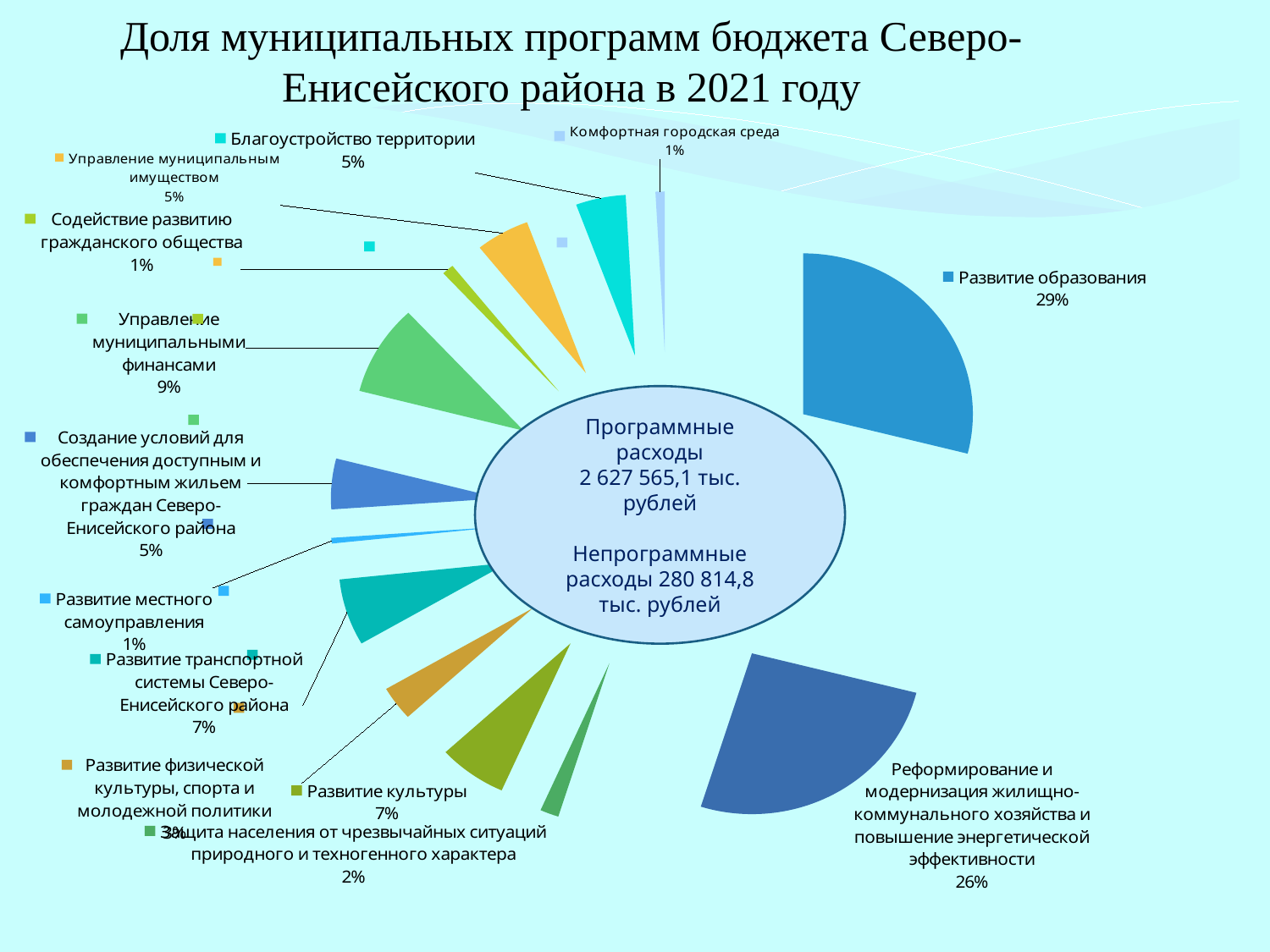
What is the combined share of Благоустройство территории and Управление муниципальным имуществом? 10% What is the difference in share between Развитие образования and Реформирование и модернизация жилищно-коммунального хозяйства и повышение энергетической эффективности? 3% What amount of Программные расходы is shown in the centre of the chart? 2 627 565,1 тыс. рублей Which has a larger share: Управление муниципальными финансами or Развитие транспортной системы Северо-Енисейского района? Управление муниципальными финансами What is the title of the chart? Доля муниципальных программ бюджета Северо-Енисейского района в 2021 году What kind of chart is shown on the slide? Pie chart What share does Развитие образования have? 29% What share does Реформирование и модернизация жилищно-коммунального хозяйства и повышение энергетической эффективности have? 26% What share does Управление муниципальными финансами have? 9% Which category has the largest share of the pie? Развитие образования What share does Развитие культуры have? 7% What share does Защита населения от чрезвычайных ситуаций природного и техногенного характера have? 2%